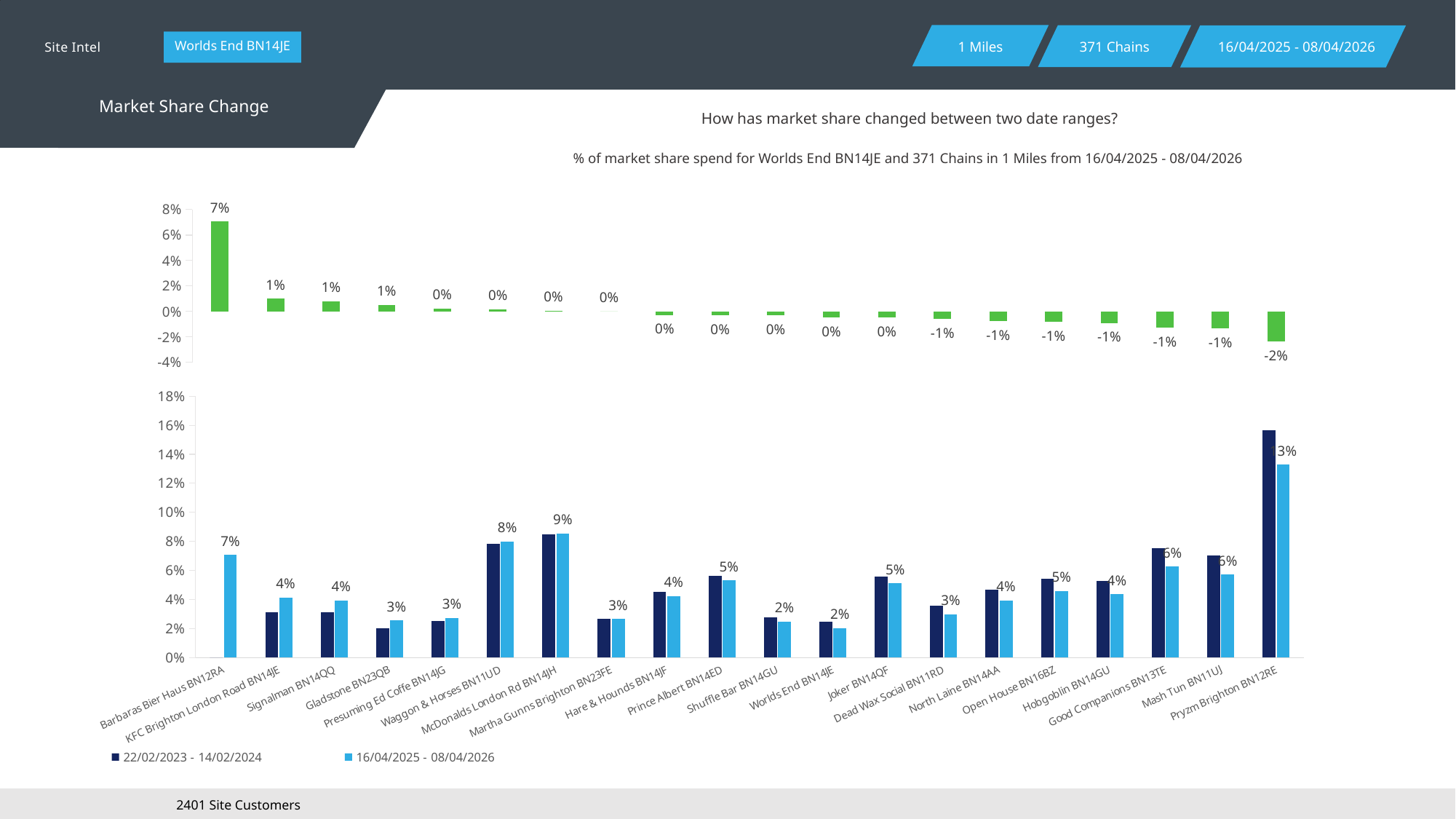
How many series does the legend of the bottom chart list? 2 How many categories are shown on the x axis of the bottom chart? 20 In the bottom chart, is the 22/02/2023 - 14/02/2024 value for Pryzm Brighton BN12RE greater or less than 14%? greater In the bottom chart, what is the labelled value for McDonalds London Rd BN14JH in the 16/04/2025 - 08/04/2026 series? 9% In the bottom chart, what is the labelled value for Pryzm Brighton BN12RE in the 16/04/2025 - 08/04/2026 series? 13% In the top chart (market share change), what is the value for Pryzm Brighton BN12RE? -2% In the top chart (market share change), what is the value for Barbaras Bier Haus BN12RA? 7% In the top chart (market share change), which category has the highest value? Barbaras Bier Haus BN12RA In the top chart (market share change), which category has the lowest value? Pryzm Brighton BN12RE In the bottom chart, which category has the highest value in the 16/04/2025 - 08/04/2026 series? Pryzm Brighton BN12RE In the bottom chart, which is larger in the 16/04/2025 - 08/04/2026 series: Waggon & Horses BN11UD or Prince Albert BN14ED? Waggon & Horses BN11UD In the top chart (market share change), what is the difference between the values for Barbaras Bier Haus BN12RA and Pryzm Brighton BN12RE? 9 percentage points